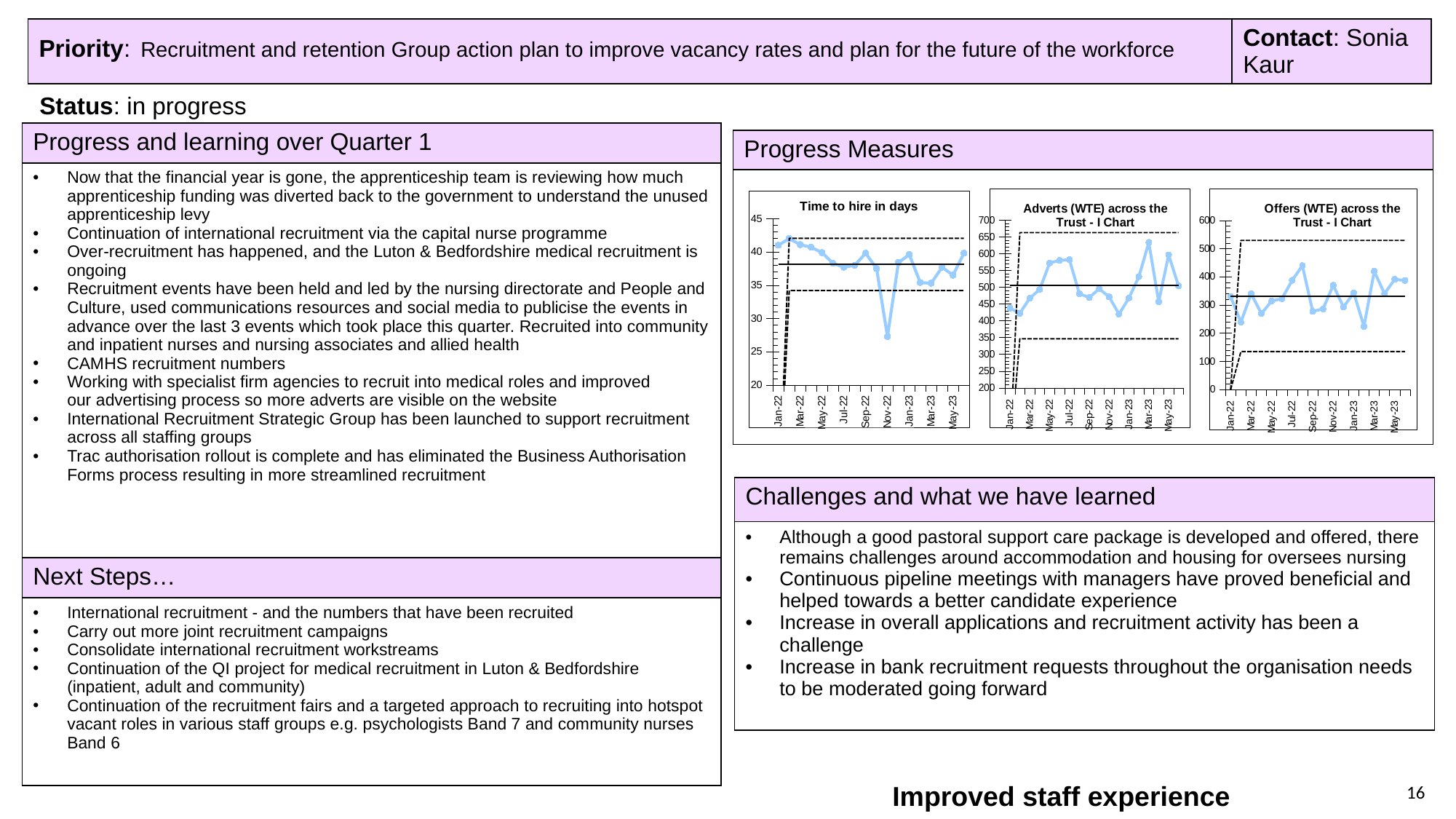
In the "Time to hire in days" chart, is the value for Nov-22 greater or less than 30? less In the "Adverts (WTE) across the Trust - I Chart", which month has the highest value? Mar-23 How many charts are shown in the Progress Measures section? 3 In the "Adverts (WTE) across the Trust - I Chart", is the value for Mar-23 greater or less than 600? greater In the "Time to hire in days" chart, which month has the lowest value? Nov-22 What is the title of the middle chart in the Progress Measures section? Adverts (WTE) across the Trust - I Chart In the "Offers (WTE) across the Trust - I Chart", is the value for Jan-23 greater or less than 300? greater What is the title of the rightmost chart in the Progress Measures section? Offers (WTE) across the Trust - I Chart What kind of chart is the "Time to hire in days" chart? line chart